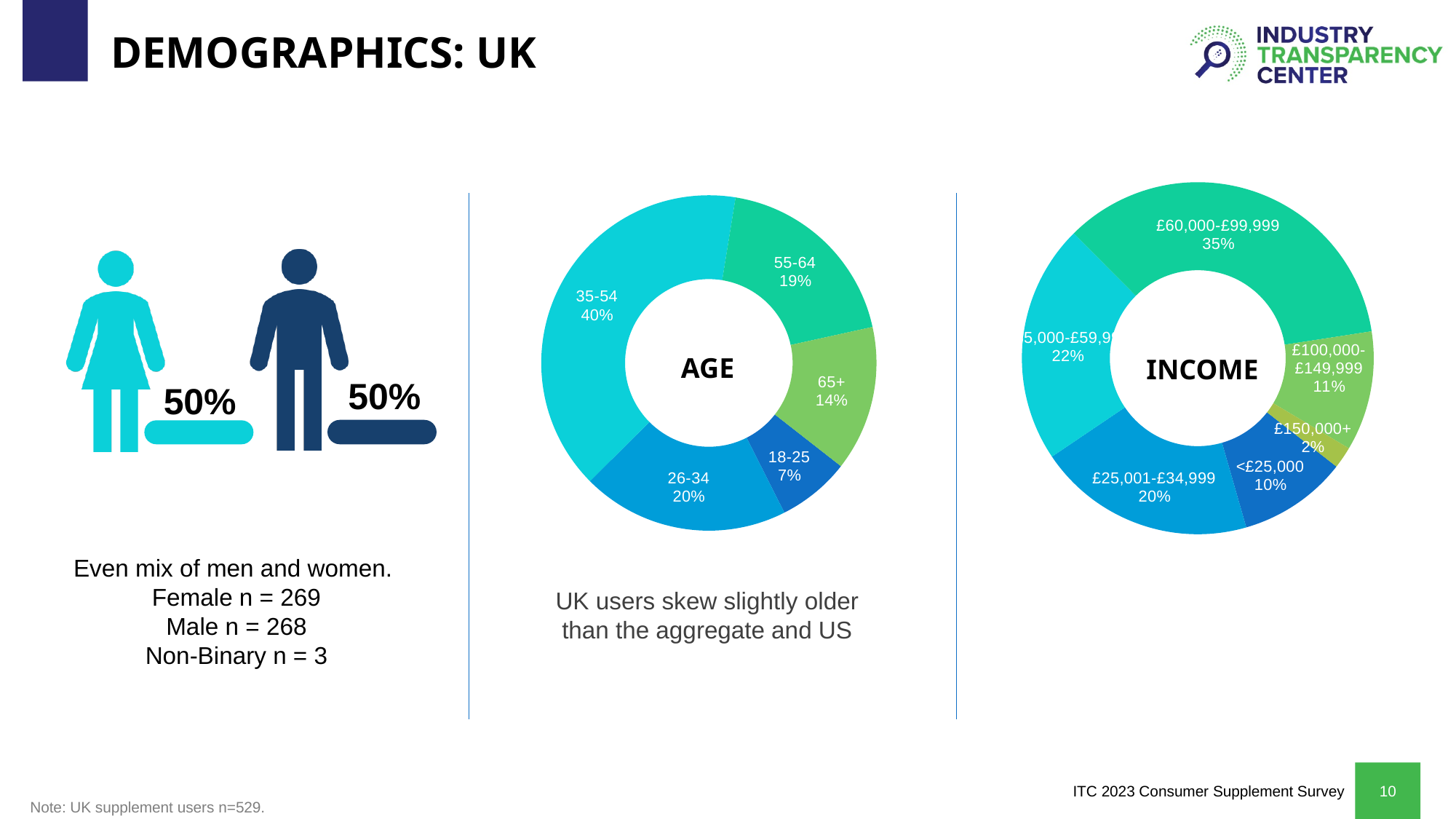
In the AGE chart, which age group has the smallest share? 18-25 In the INCOME chart, which is larger: the share for <£25,000 or the share for £100,000-£149,999? £100,000-£149,999 In the AGE chart, which age group has the largest share? 35-54 What type of chart is the AGE chart? Donut (pie) chart In the AGE chart, what is the difference in percentage points between the 35-54 group and the 26-34 group? 20 percentage points How many age groups are shown in the AGE chart? 5 In the INCOME chart, which income bracket has the largest share? £60,000-£99,999 In the AGE chart, what percentage of UK users are aged 35-54? 40% In the INCOME chart, which income bracket has the smallest share? £150,000+ How many income brackets are shown in the INCOME chart? 6 In the INCOME chart, what percentage of UK users earn £60,000-£99,999? 35% In the AGE chart, what share of UK users are 65+? 14%